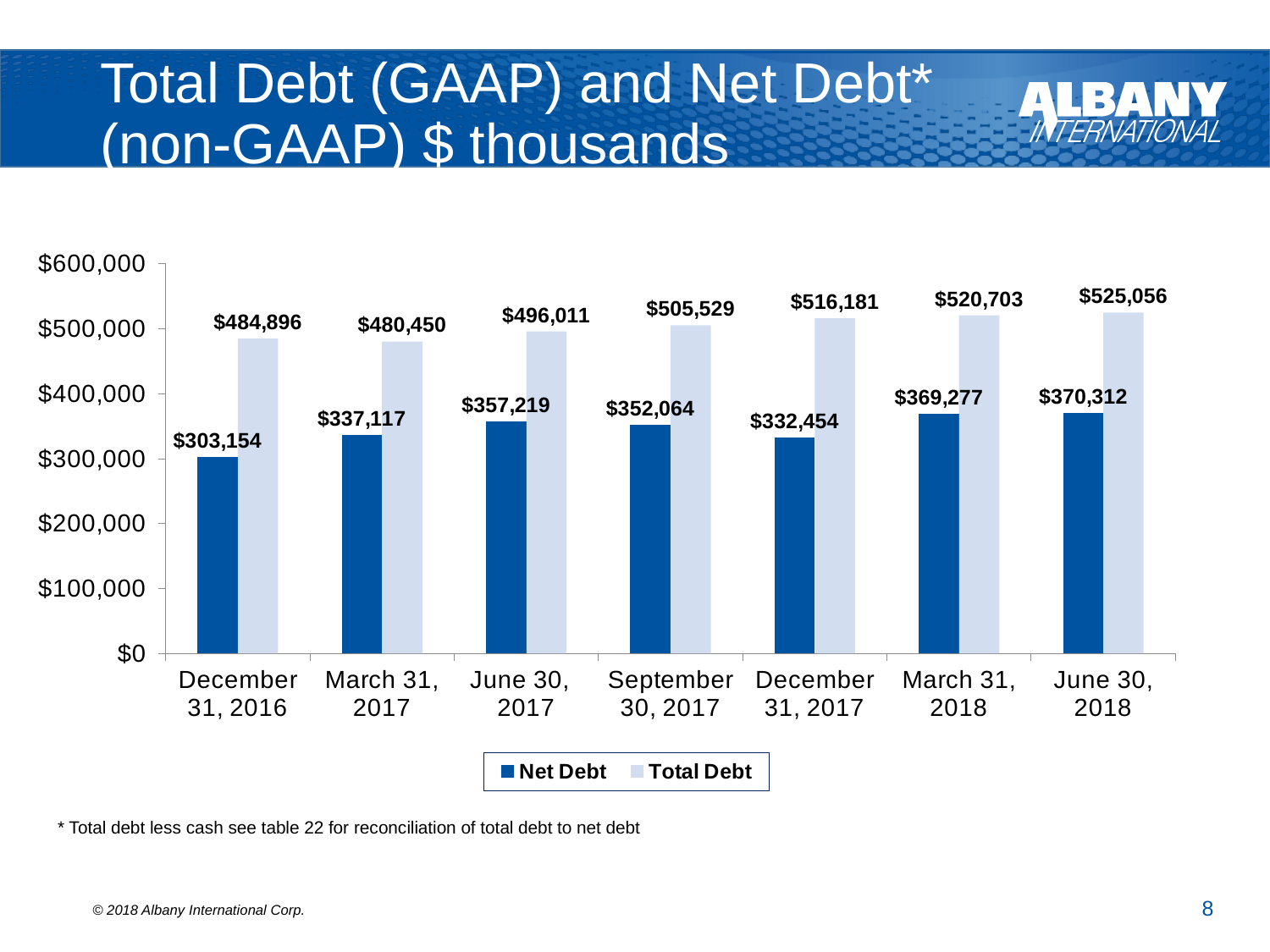
How many dates are shown on the x axis? 7 Which date has the highest Total Debt? June 30, 2018 Which date has the lowest Total Debt? March 31, 2017 By how much did Net Debt increase from December 31, 2017 to March 31, 2018? $36,823 Which date has the lowest Net Debt? December 31, 2016 What type of chart is shown on the slide? Bar chart What is the difference between Total Debt and Net Debt on June 30, 2018? $154,744 What is the Total Debt value for June 30, 2018? $525,056 What is the Net Debt value for December 31, 2016? $303,154 Which is larger, Net Debt on June 30, 2017 or Net Debt on December 31, 2017? June 30, 2017 How many series does the legend list? 2 What is the Net Debt value for September 30, 2017? $352,064